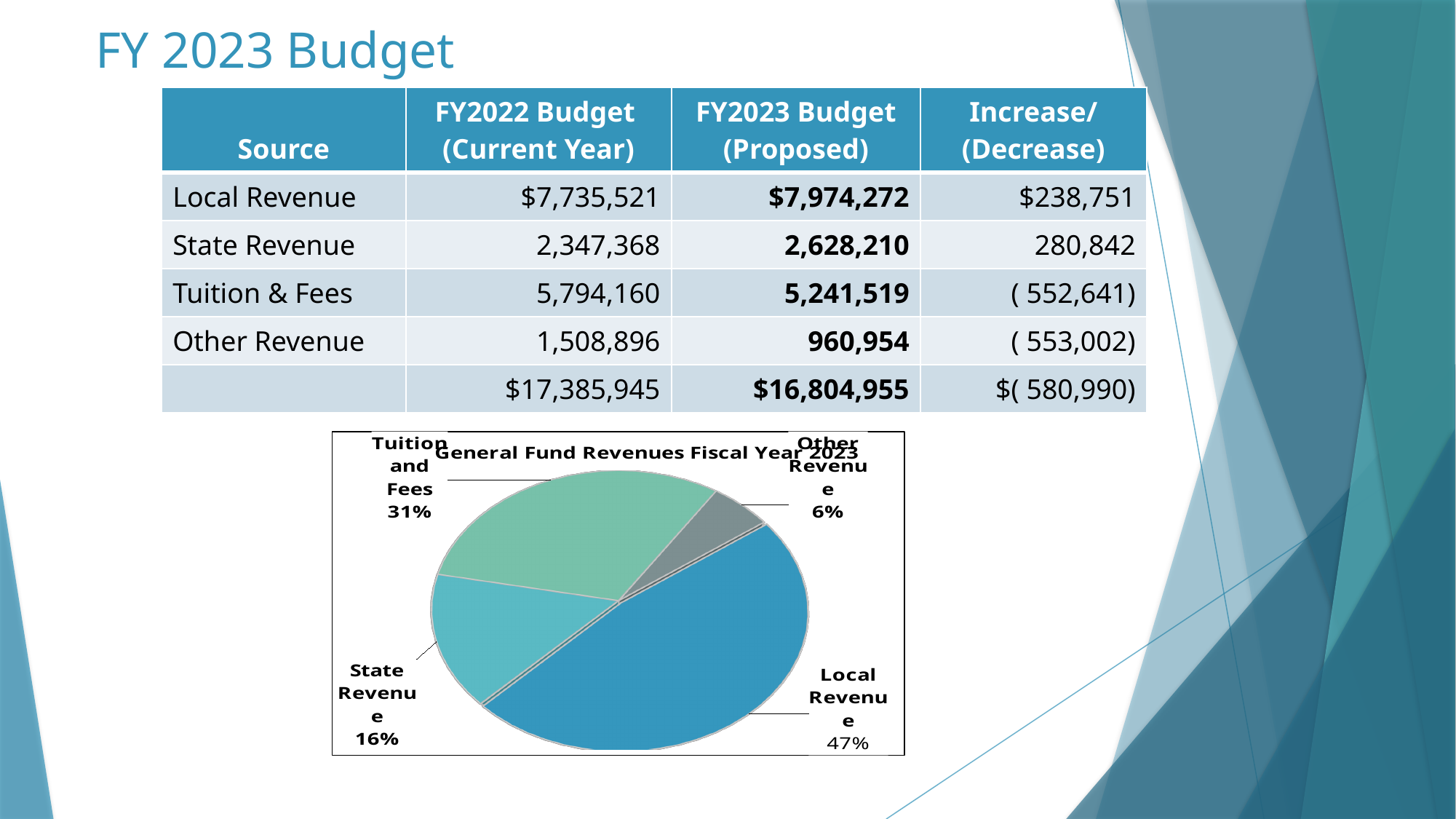
What share of the pie does Local Revenue represent? 47% What is the combined share of the State Revenue and Other Revenue slices? 22% What is the title of the pie chart? General Fund Revenues Fiscal Year 2023 What is the difference in percentage points between the Local Revenue and Tuition and Fees slices? 16 Which slice of the pie chart is the smallest? Other Revenue How many slices does the pie chart have? 4 What share of the pie does State Revenue represent? 16% Which slice is larger, State Revenue or Tuition and Fees? Tuition and Fees What share of the pie does Tuition and Fees represent? 31% Which slice of the pie chart is the largest? Local Revenue What kind of chart is shown on the slide? Pie chart